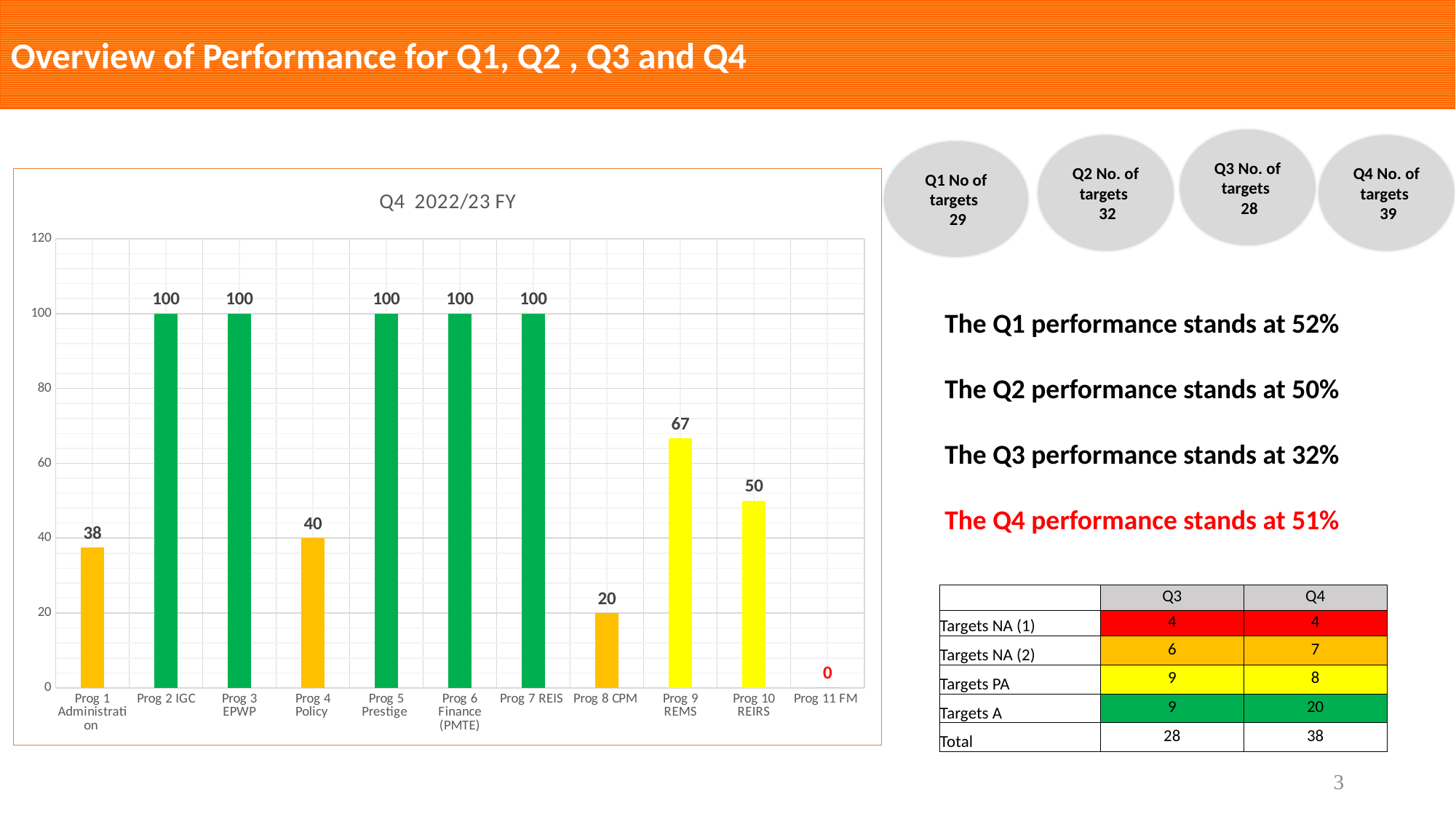
What is the difference between the values for Prog 9 REMS and Prog 10 REIRS in the Q4 2022/23 FY chart? 17 What is the title of the chart on the slide? Q4 2022/23 FY What is the value for Prog 1 Administration in the Q4 2022/23 FY chart? 38 How many categories are shown on the x axis of the Q4 2022/23 FY chart? 11 What is the value for Prog 8 CPM in the Q4 2022/23 FY chart? 20 What is the value for Prog 11 FM in the Q4 2022/23 FY chart? 0 What is the value for Prog 9 REMS in the Q4 2022/23 FY chart? 67 Which category has the lowest value in the Q4 2022/23 FY chart? Prog 11 FM How many categories in the Q4 2022/23 FY chart have a value of 100? 5 Which is larger in the Q4 2022/23 FY chart, the value for Prog 4 Policy or the value for Prog 1 Administration? Prog 4 Policy What kind of chart is the Q4 2022/23 FY chart? bar chart Is the value for Prog 10 REIRS greater or less than 60 in the Q4 2022/23 FY chart? less